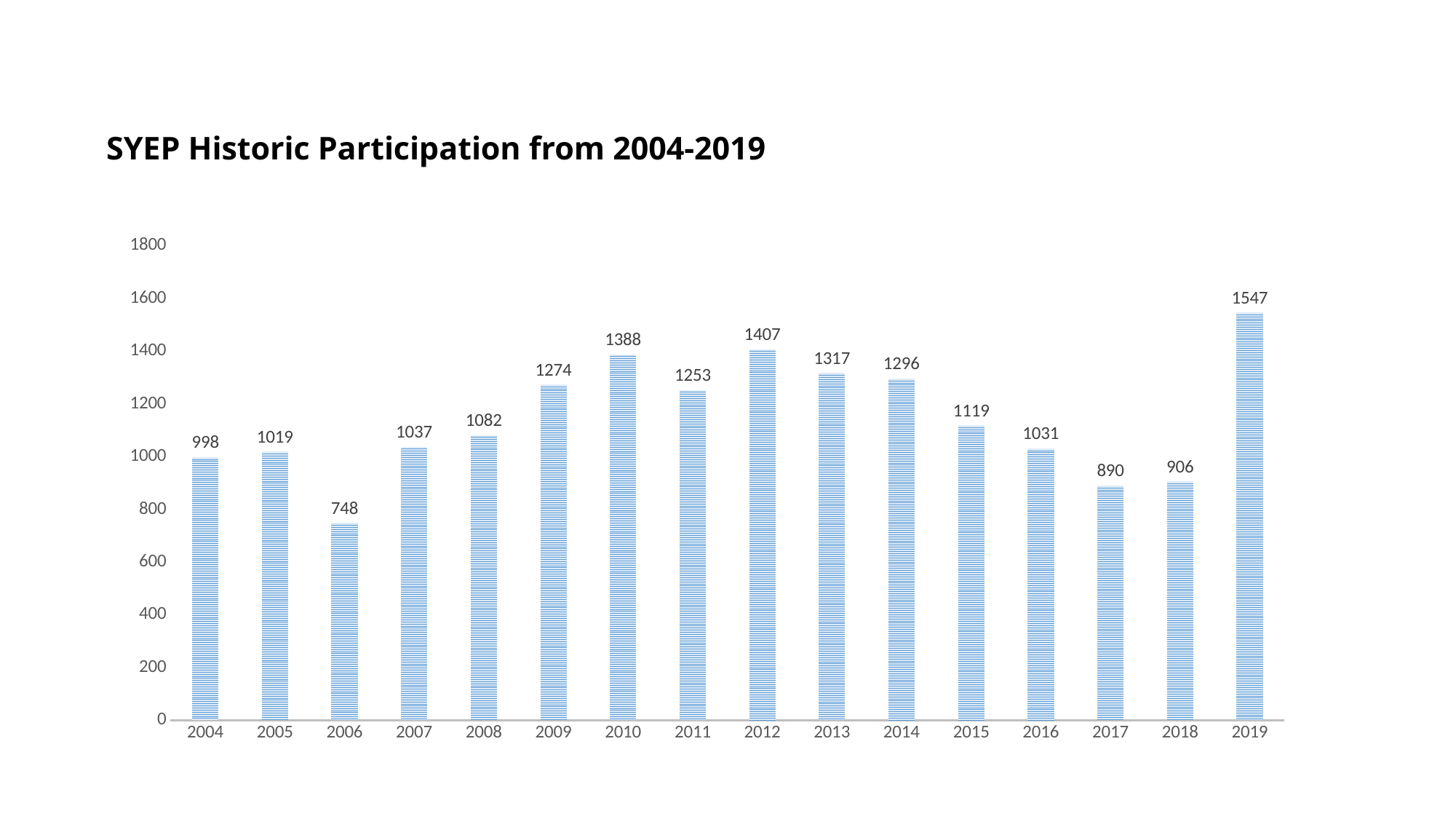
Which year has the highest participation? 2019 Which year has higher participation, 2009 or 2014? 2014 What kind of chart is shown on the slide? Bar chart What is the participation value for 2012? 1407 What is the title of the chart? SYEP Historic Participation from 2004-2019 What is the participation value for 2017? 890 What is the difference between the participation in 2019 and in 2018? 641 Which year has the lowest participation? 2006 Is the value for 2015 greater or less than 1000? greater How many years are shown on the x axis? 16 What is the participation value for 2006? 748 What is the difference between the participation in 2010 and in 2011? 135